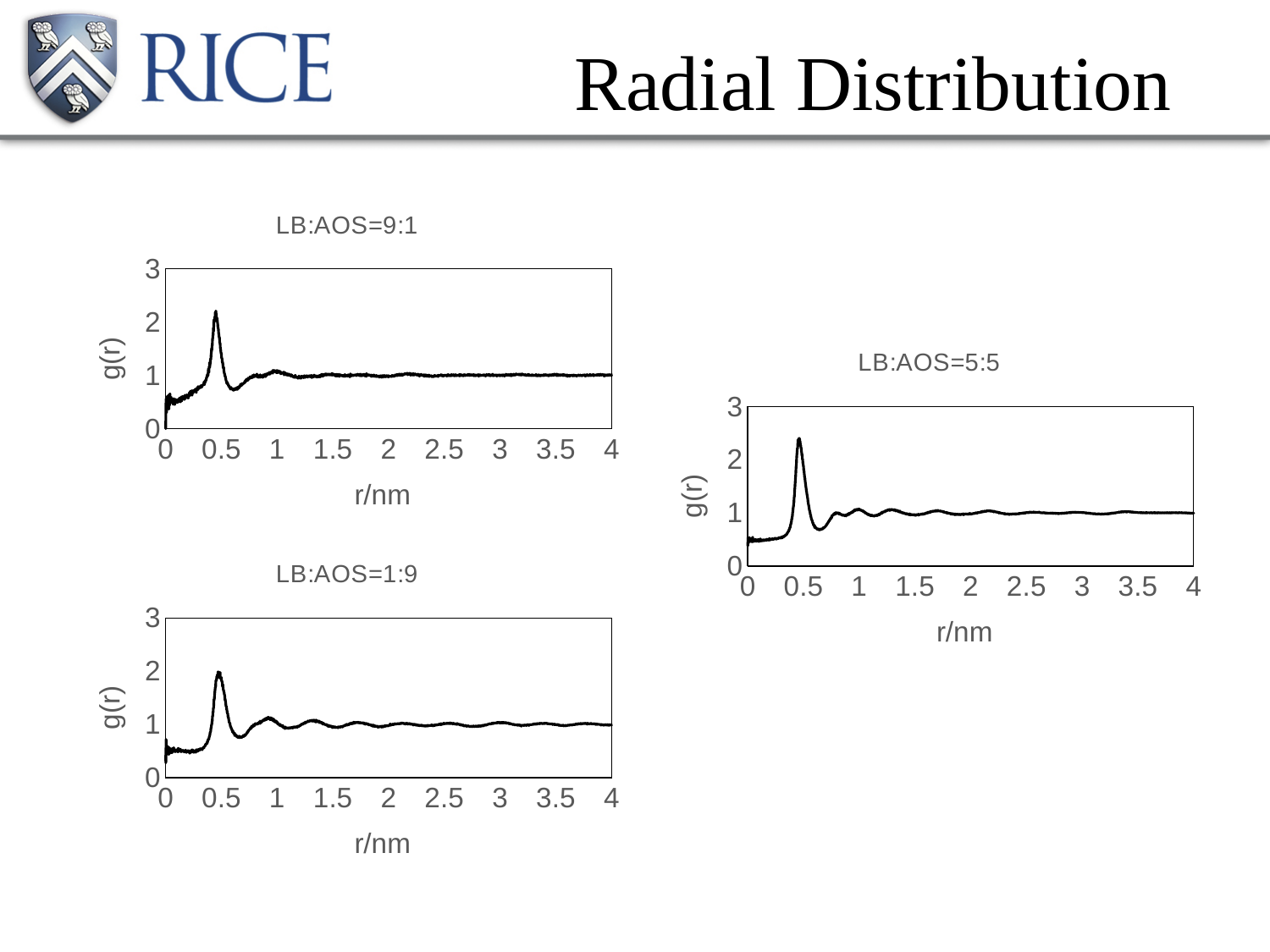
In the LB:AOS=9:1 chart, is the peak value of g(r) greater or less than 1? greater How many charts are shown on the slide? 3 What is the title of the chart on the right side of the slide? LB:AOS=5:5 What is the maximum value shown on the y-axis of the LB:AOS=5:5 chart? 3 In the LB:AOS=9:1 chart, is the value of g(r) at r/nm = 4 greater or less than 2? less In the LB:AOS=1:9 chart, is the value of g(r) at r/nm = 0 greater or less than 1? less Which chart has the higher peak g(r) value, LB:AOS=5:5 or LB:AOS=1:9? LB:AOS=5:5 What kind of chart is the LB:AOS=9:1 chart? line chart What is the x-axis label of the LB:AOS=1:9 chart? r/nm